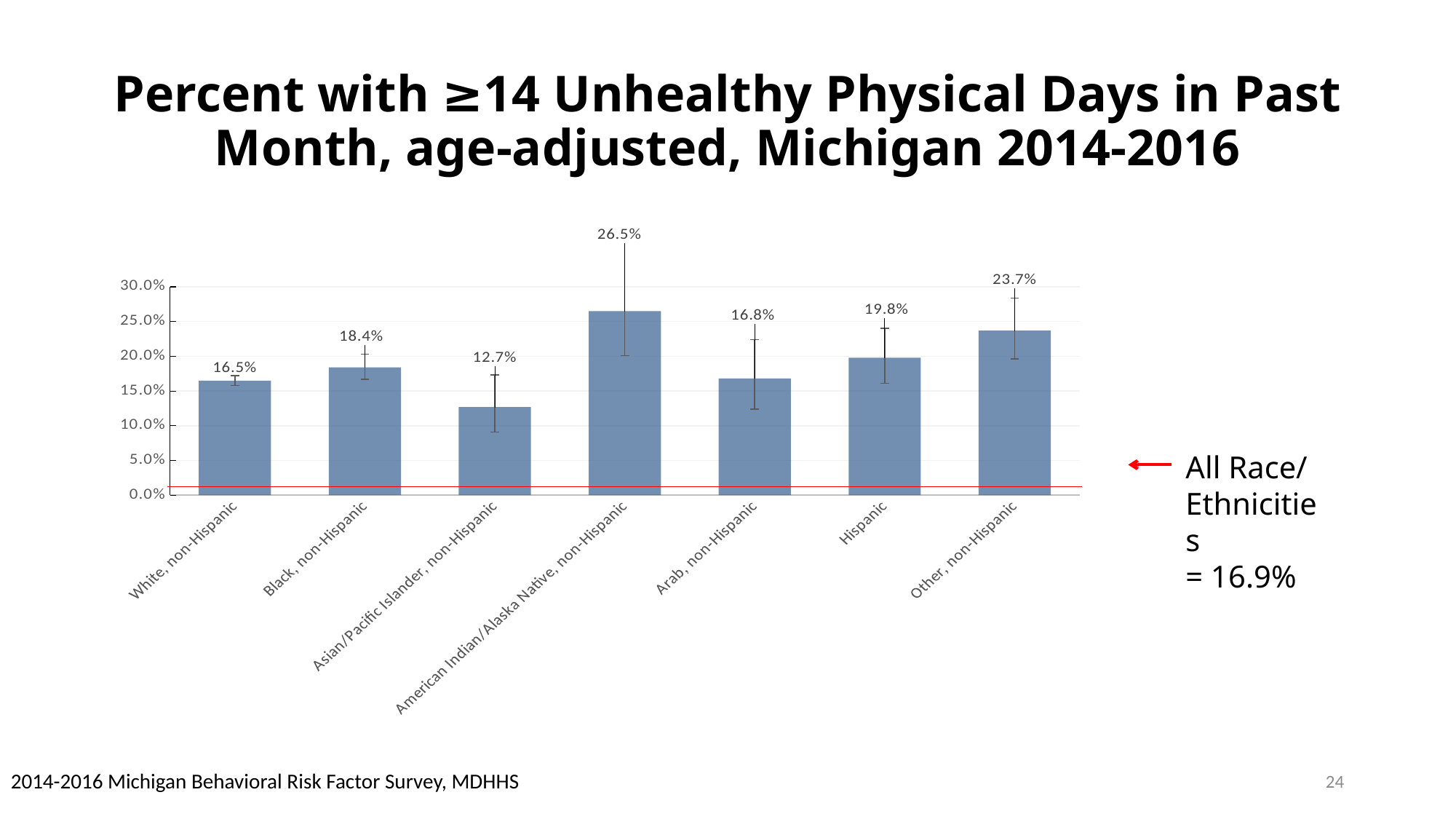
Which category has the lowest value? Asian/Pacific Islander, non-Hispanic What is the value for Asian/Pacific Islander, non-Hispanic? 12.7% What is the value for Other, non-Hispanic? 23.7% What value does the red horizontal line labelled All Race/Ethnicities represent? 16.9% What kind of chart is shown on the slide? bar chart What is the difference between the values for Black, non-Hispanic and White, non-Hispanic? 1.9% Which category has the highest value? American Indian/Alaska Native, non-Hispanic What is the value for American Indian/Alaska Native, non-Hispanic? 26.5% Which is larger, the value for Hispanic or the value for Arab, non-Hispanic? Hispanic What is the value for Hispanic? 19.8% How many race/ethnicity categories are shown in the chart? 7 Is the value for Other, non-Hispanic greater or less than 20.0%? greater